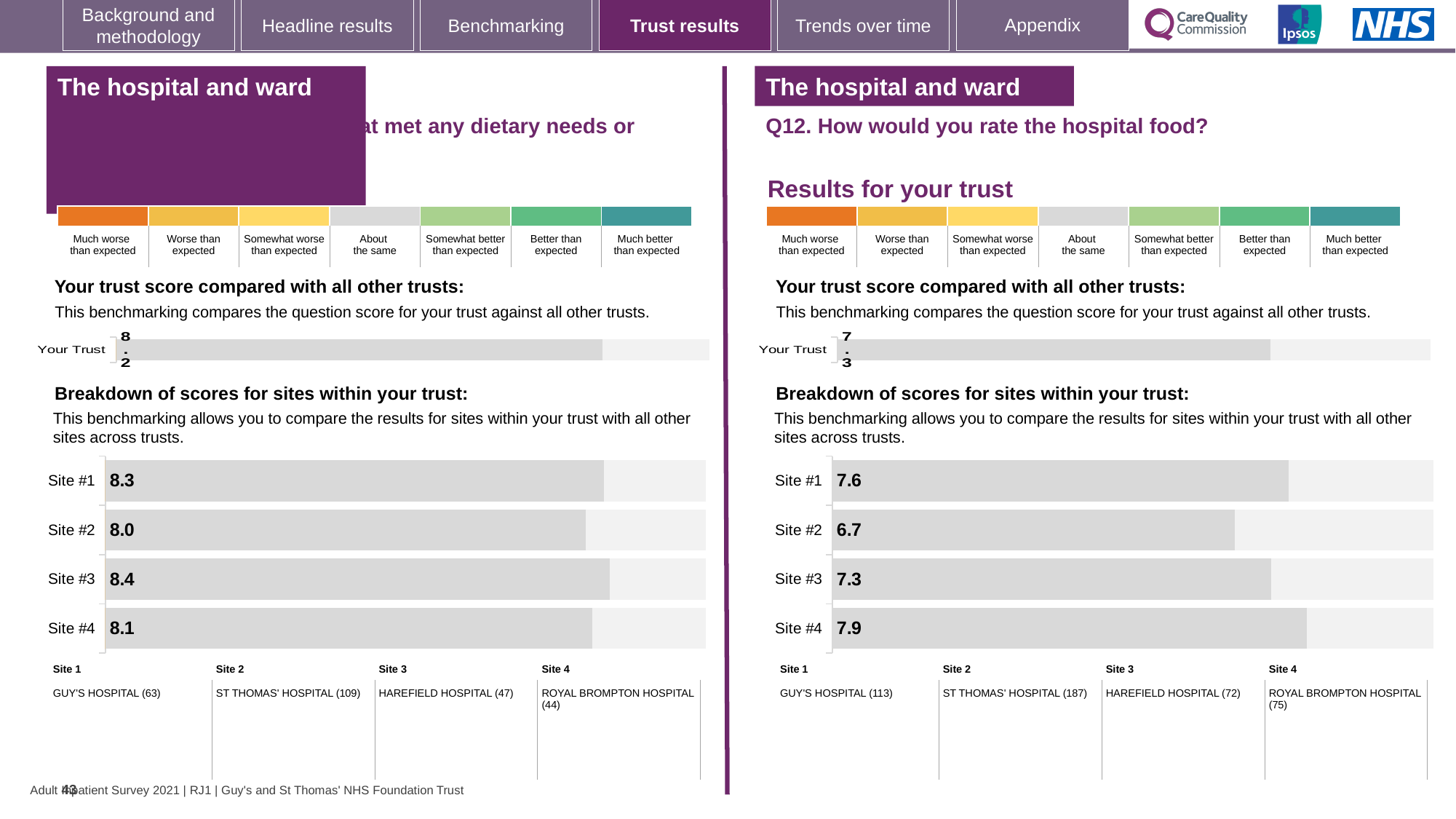
What type of chart is used for the site breakdown in the Q12 hospital food section on the right? Bar chart In the Q12 hospital food chart on the right, what is the difference between the scores for Site #4 and Site #2? 1.2 In the site breakdown chart on the left-hand side of the slide, is the score for Site #1 or Site #4 larger? Site #1 In the Q12 hospital food chart on the right, what is the score for Site #1? 7.6 In the site breakdown chart on the left-hand side of the slide, what is the difference between the scores for Site #3 and Site #2? 0.4 How many sites are shown in the Q12 hospital food site breakdown chart on the right? 4 In the Q12 hospital food chart on the right, what is the 'Your Trust' score? 7.3 In the Q12 hospital food chart on the right, which site has the lowest score? Site #2 In the Q12 hospital food chart on the right, what is the score for Site #2? 6.7 In the site breakdown chart on the left-hand side of the slide, which site has the lowest score? Site #2 In the Q12 hospital food chart on the right, which site has the highest score? Site #4 In the site breakdown chart on the left-hand side of the slide, what is the score for Site #3? 8.4